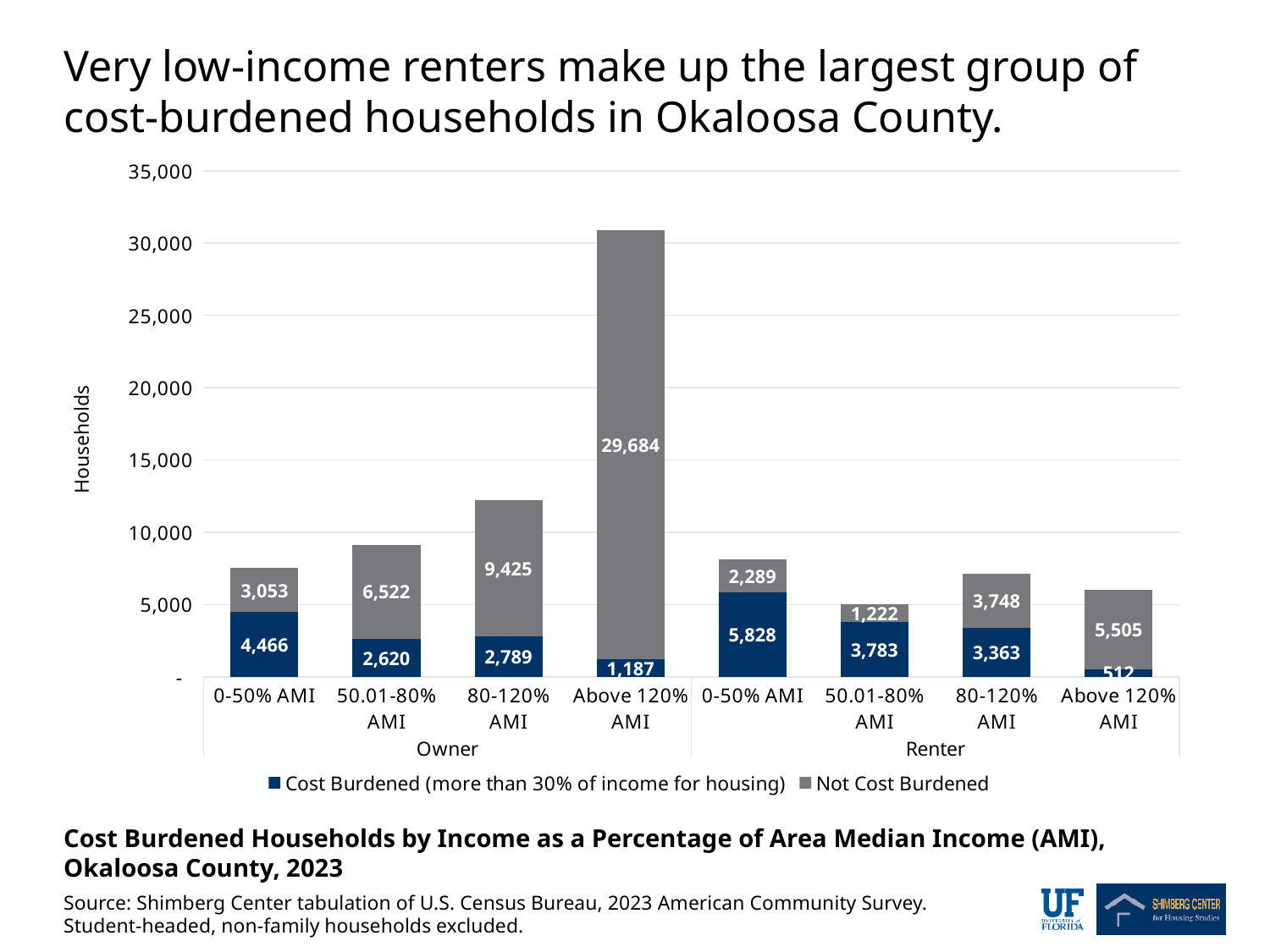
What is the total number of households in the Owner 0-50% AMI bar? 7,519 How many income-category bars are plotted in the chart? 8 How many series does the legend list? 2 Is the total height of the Owner Above 120% AMI bar greater or less than 30,000? greater How many cost-burdened owner households are in the 80-120% AMI group? 2,789 How many cost-burdened renter households are in the 0-50% AMI group? 5,828 What kind of chart is shown on the slide? Stacked bar chart Which bar has the largest total number of households? Owner Above 120% AMI Which income group has the largest number of cost-burdened households? Renter 0-50% AMI How many not-cost-burdened owner households are in the Above 120% AMI group? 29,684 Which is larger: the number of cost-burdened owner households at 50.01-80% AMI or the number of cost-burdened renter households at 50.01-80% AMI? Renter 50.01-80% AMI What is the difference between cost-burdened renter households at 0-50% AMI and cost-burdened owner households at 0-50% AMI? 1,362